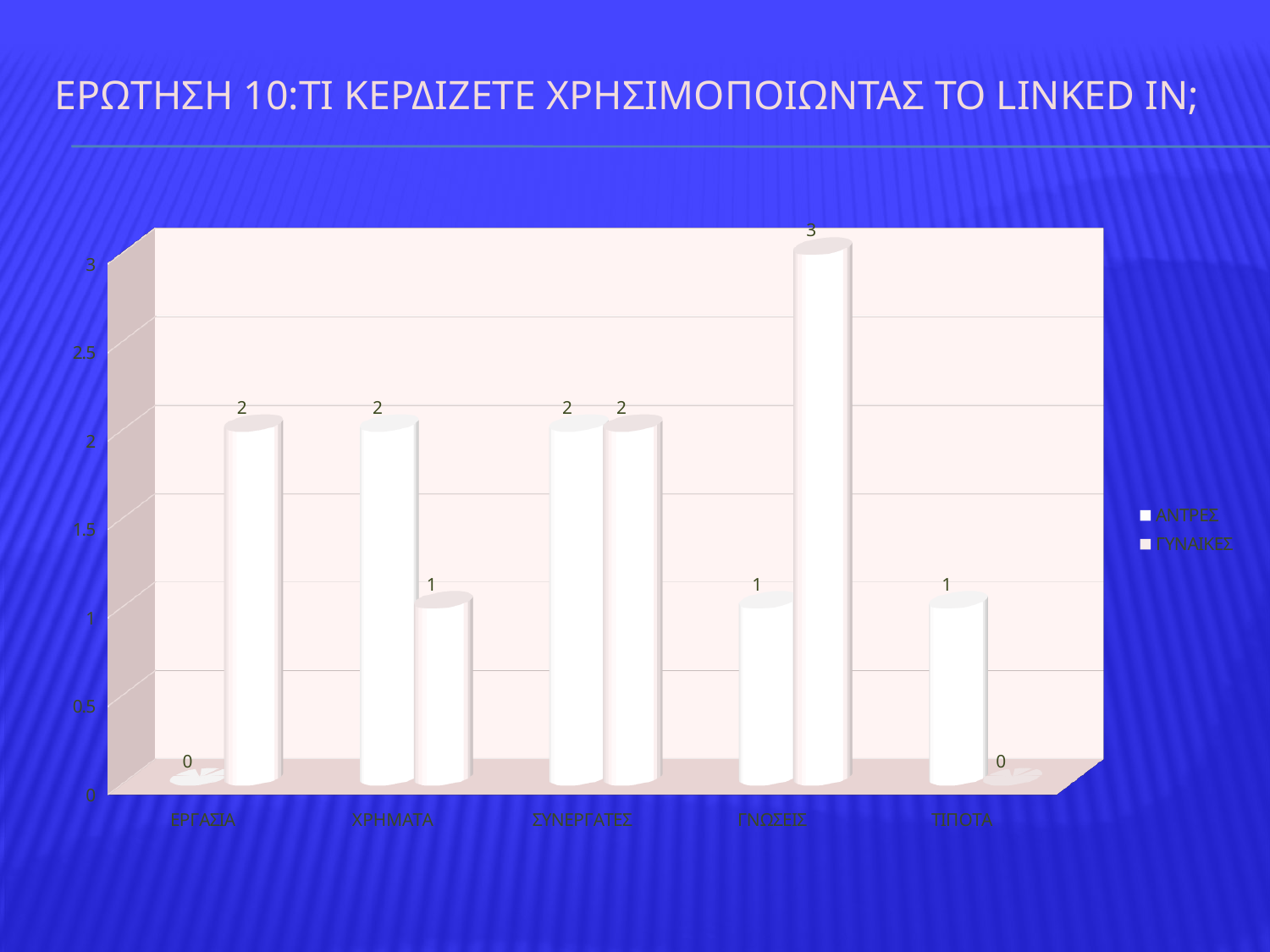
What is the value of the left bar for ΕΡΓΑΣΙΑ? 0 Which is larger: the left bar for ΧΡΗΜΑΤΑ or the right bar for ΧΡΗΜΑΤΑ? the left bar Which category has the highest single bar in the chart? ΓΝΩΣΕΙΣ What are the two series names listed in the chart legend? ΑΝΤΡΕΣ and ΓΥΝΑΙΚΕΣ What is the value of the right bar for ΤΙΠΟΤΑ? 0 What type of chart is shown on the slide? bar chart How many categories are shown on the x axis of the chart? 5 What is the difference between the two bars for ΓΝΩΣΕΙΣ? 2 How many series does the chart legend list? 2 What is the value of the right bar for ΓΝΩΣΕΙΣ? 3 What is the combined total of the two bars for ΣΥΝΕΡΓΑΤΕΣ? 4 What is the value of the right bar for ΧΡΗΜΑΤΑ? 1